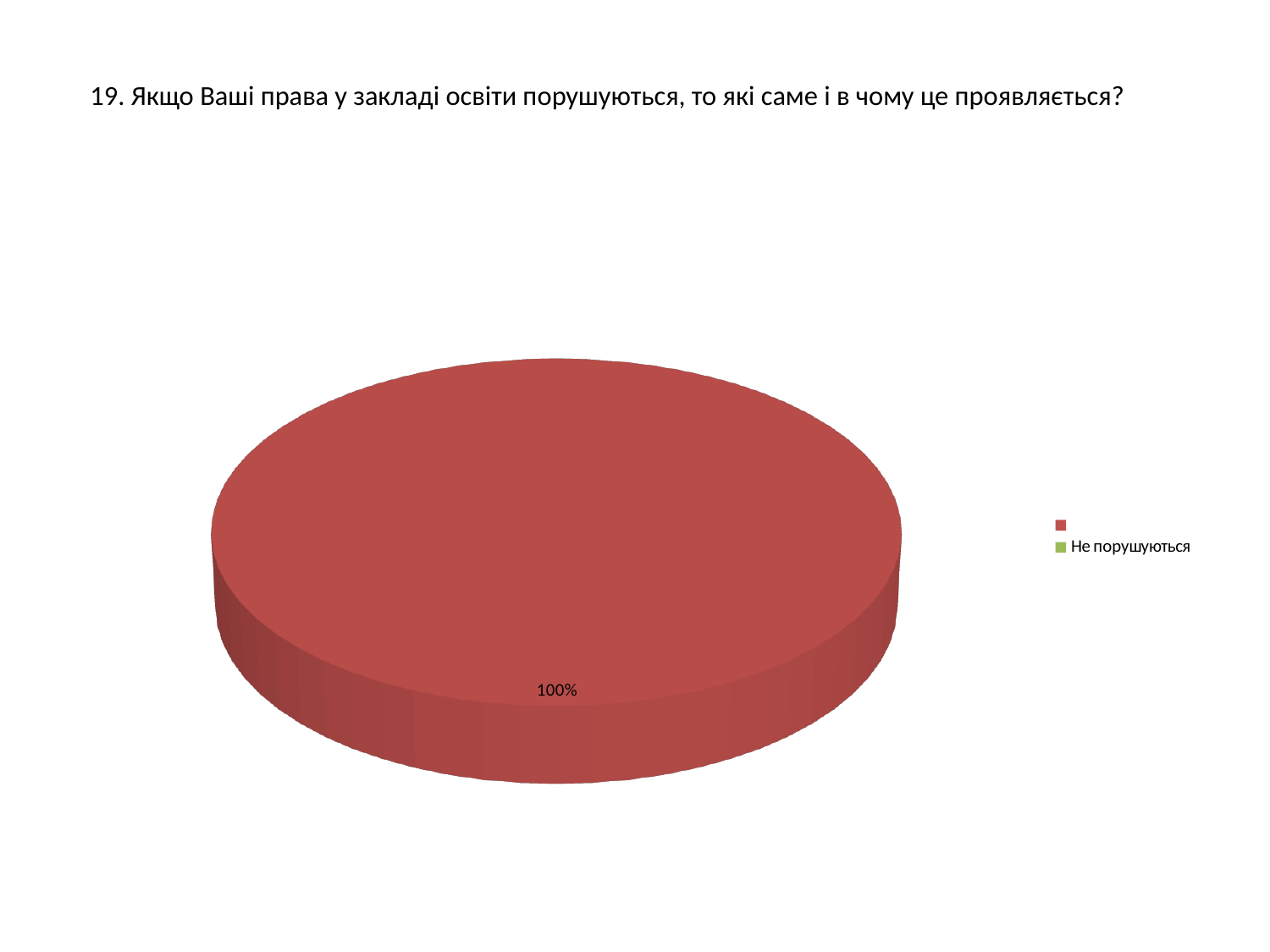
What colour is the slice that makes up the whole pie? red How many entries does the legend of the pie chart list? 2 What kind of chart is shown on the slide? pie chart What share of the pie does the single visible red slice take up? 100% What percentage is printed as the data label on the pie chart? 100% What is the text of the legend entry with the green marker? Не порушуються How many slices are visible in the pie chart? 1